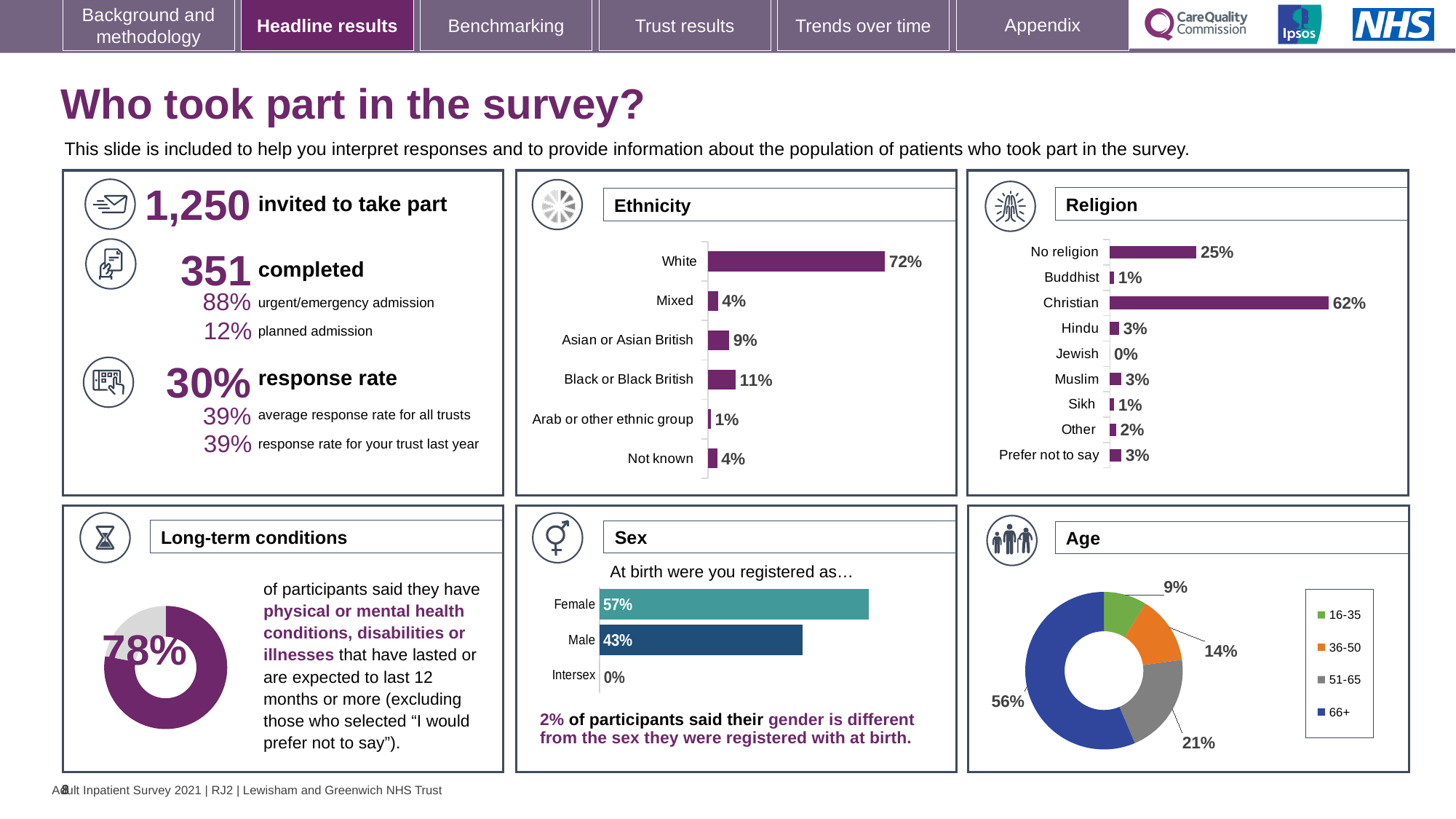
How many categories are shown in the Ethnicity chart? 6 How many age groups does the legend of the Age chart list? 4 In the Age chart, what share of participants were aged 66+? 56% In the Religion chart, what percentage of participants said they had no religion? 25% In the Ethnicity chart, what percentage of participants were White? 72% In the Religion chart, which religion category has the highest percentage? Christian In the Ethnicity chart, which ethnic group has the lowest percentage? Arab or other ethnic group What type of chart is used for the Age breakdown? Doughnut chart In the Ethnicity chart, what is the difference between the percentages for Black or Black British and Asian or Asian British? 2% How many categories are shown in the Religion chart? 9 In the Sex chart, what percentage of participants were registered as Female at birth? 57% In the Religion chart, which is larger: the percentage for Hindu or the percentage for Sikh? Hindu